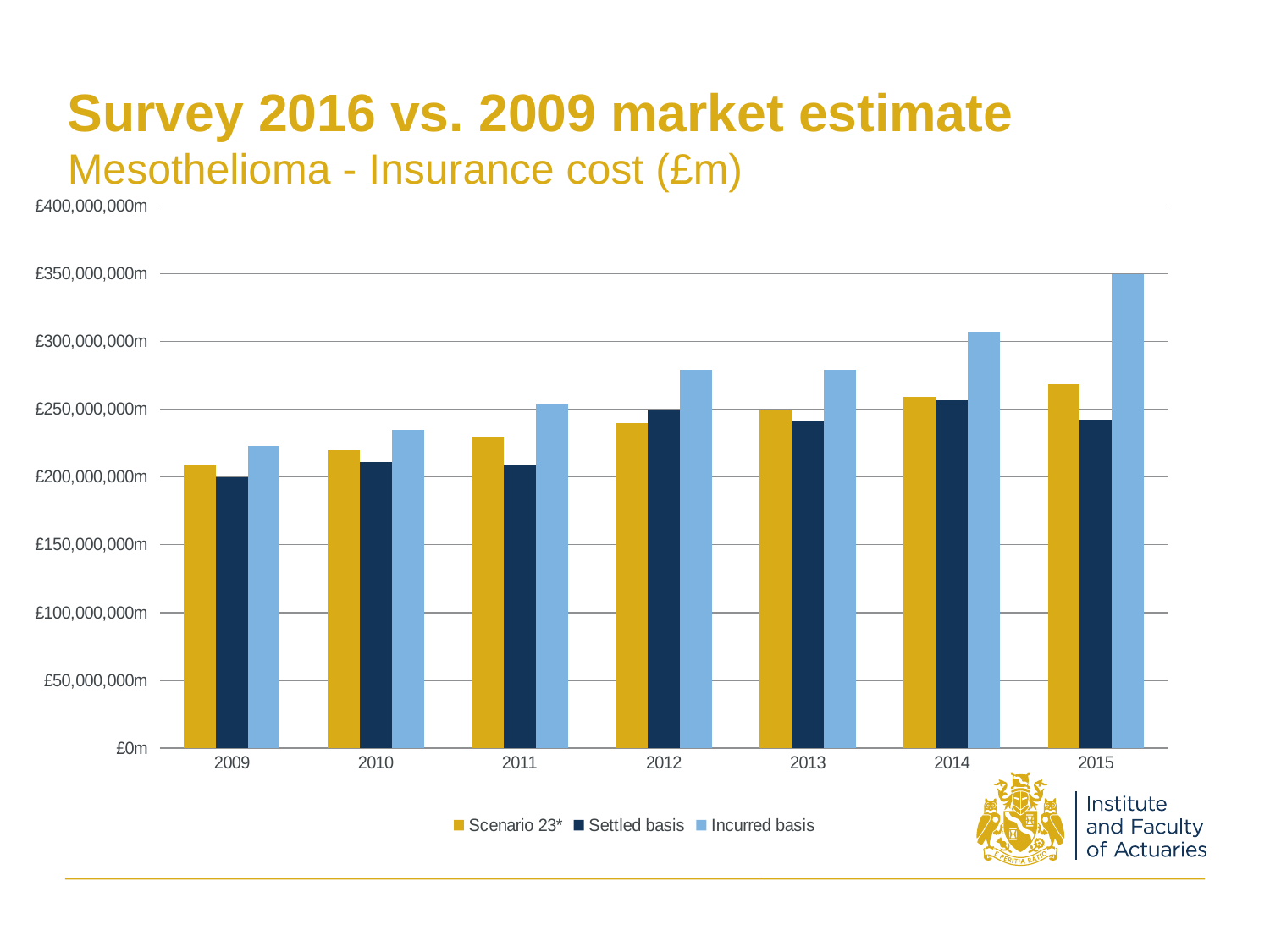
How many series does the legend list? 3 Is the Scenario 23* value for 2015 greater or less than £250,000,000m? greater What are the three series named in the legend? Scenario 23*, Settled basis, Incurred basis What kind of chart is shown on the slide? Bar chart Which year has the highest Scenario 23* value? 2015 Is the Incurred basis value for 2012 greater or less than £300,000,000m? less Do the Incurred basis values rise or fall from 2009 to 2015? rise Which year has the lowest Incurred basis value? 2009 In 2012, which is larger: the Settled basis value or the Scenario 23* value? Settled basis Which year has the highest Incurred basis value? 2015 How many years are shown on the x axis? 7 In 2015, which is larger: the Incurred basis value or the Settled basis value? Incurred basis